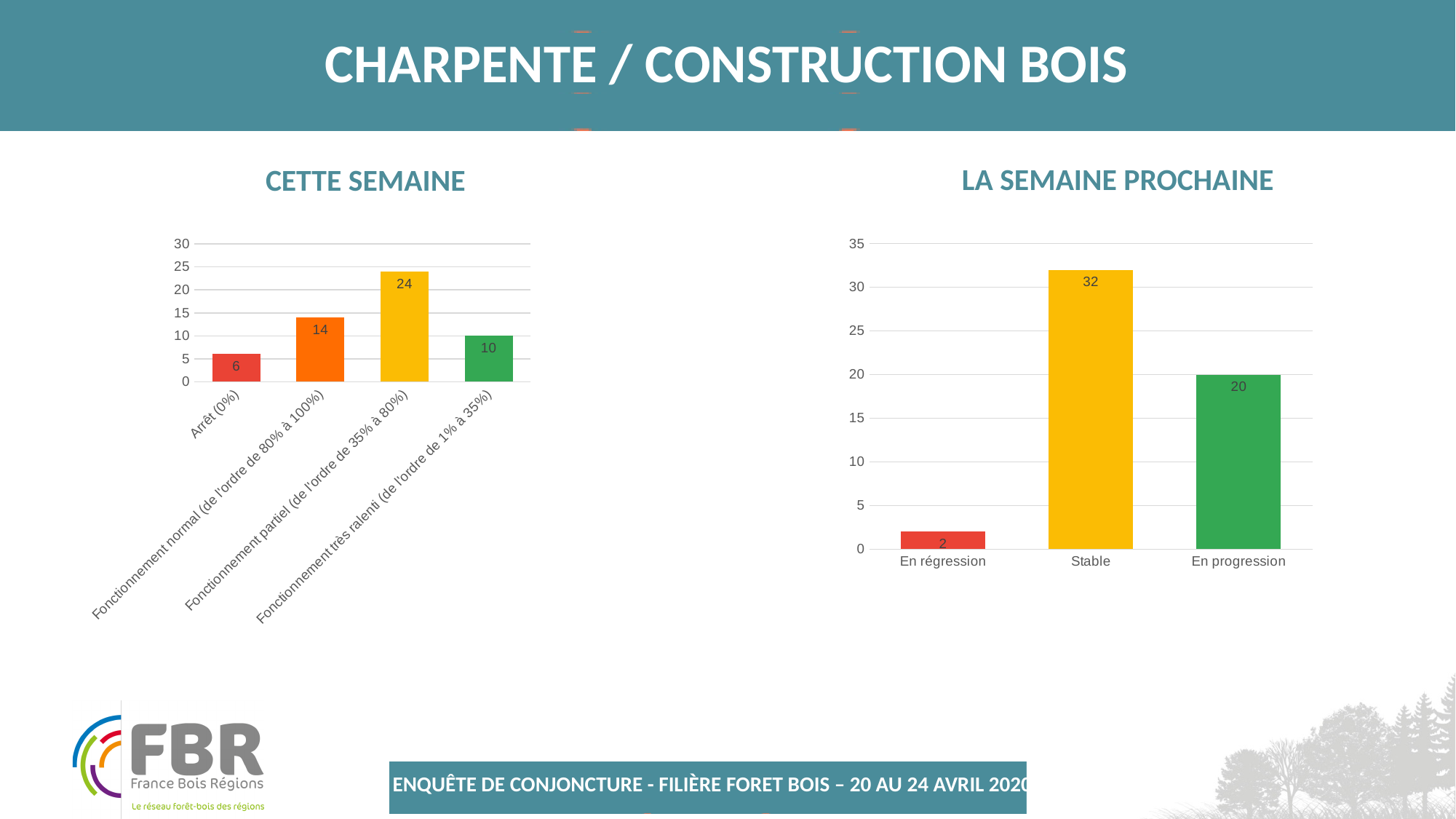
In the 'LA SEMAINE PROCHAINE' chart, which category has the lowest value? En régression In the 'CETTE SEMAINE' chart, what is the value for 'Fonctionnement partiel (de l'ordre de 35% à 80%)'? 24 In the 'CETTE SEMAINE' chart, how many categories are shown? 4 In the 'LA SEMAINE PROCHAINE' chart, what is the difference between 'Stable' and 'En progression'? 12 What kind of chart is the 'LA SEMAINE PROCHAINE' chart? Bar chart In the 'CETTE SEMAINE' chart, what is the value for 'Arrêt (0%)'? 6 In the 'LA SEMAINE PROCHAINE' chart, what is the value for 'En régression'? 2 In the 'LA SEMAINE PROCHAINE' chart, which is larger, 'En progression' or 'En régression'? En progression In the 'CETTE SEMAINE' chart, which category has the lowest value? Arrêt (0%) In the 'CETTE SEMAINE' chart, what is the difference between 'Fonctionnement normal (de l'ordre de 80% à 100%)' and 'Fonctionnement très ralenti (de l'ordre de 1% à 35%)'? 4 In the 'CETTE SEMAINE' chart, which category has the highest value? Fonctionnement partiel (de l'ordre de 35% à 80%) In the 'LA SEMAINE PROCHAINE' chart, what is the value for 'Stable'? 32